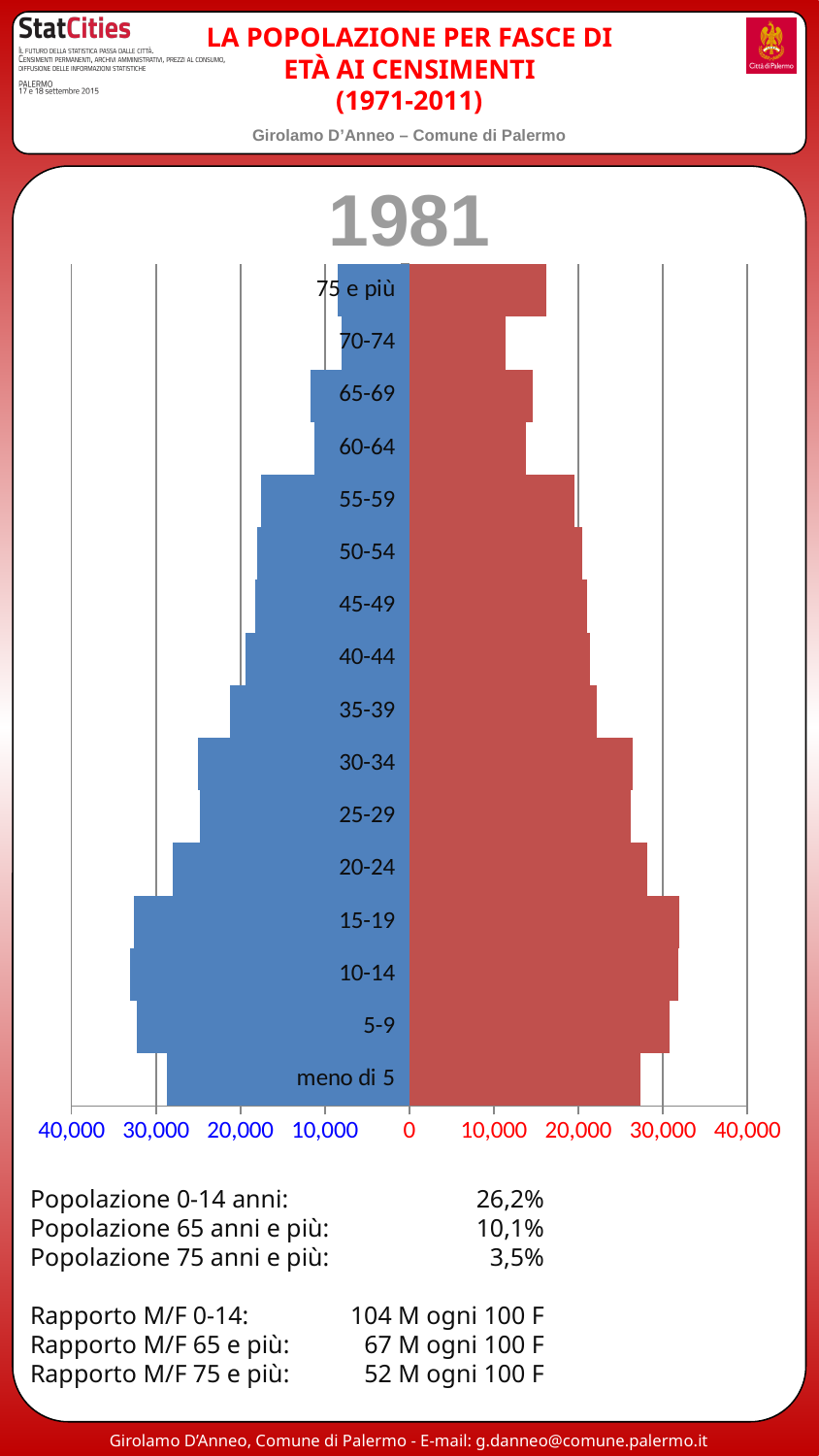
What kind of chart is shown on the slide? bar chart Moving from the 15-19 age group up to the 75 e più age group, do the blue bars get longer or shorter? shorter How many age groups are shown on the chart? 16 Is the blue bar for the 55-59 age group greater or less than 20,000? less Which age group has the shortest blue bar? 70-74 What colour are the bars on the left side of the chart? blue Which age group has the shortest red bar? 70-74 For the 75 e più age group, which bar is longer, the blue one or the red one? the red one Is the blue bar for the 75 e più age group greater or less than 10,000? less Is the red bar for the 75 e più age group greater or less than 10,000? greater What year is shown as the title above the chart? 1981